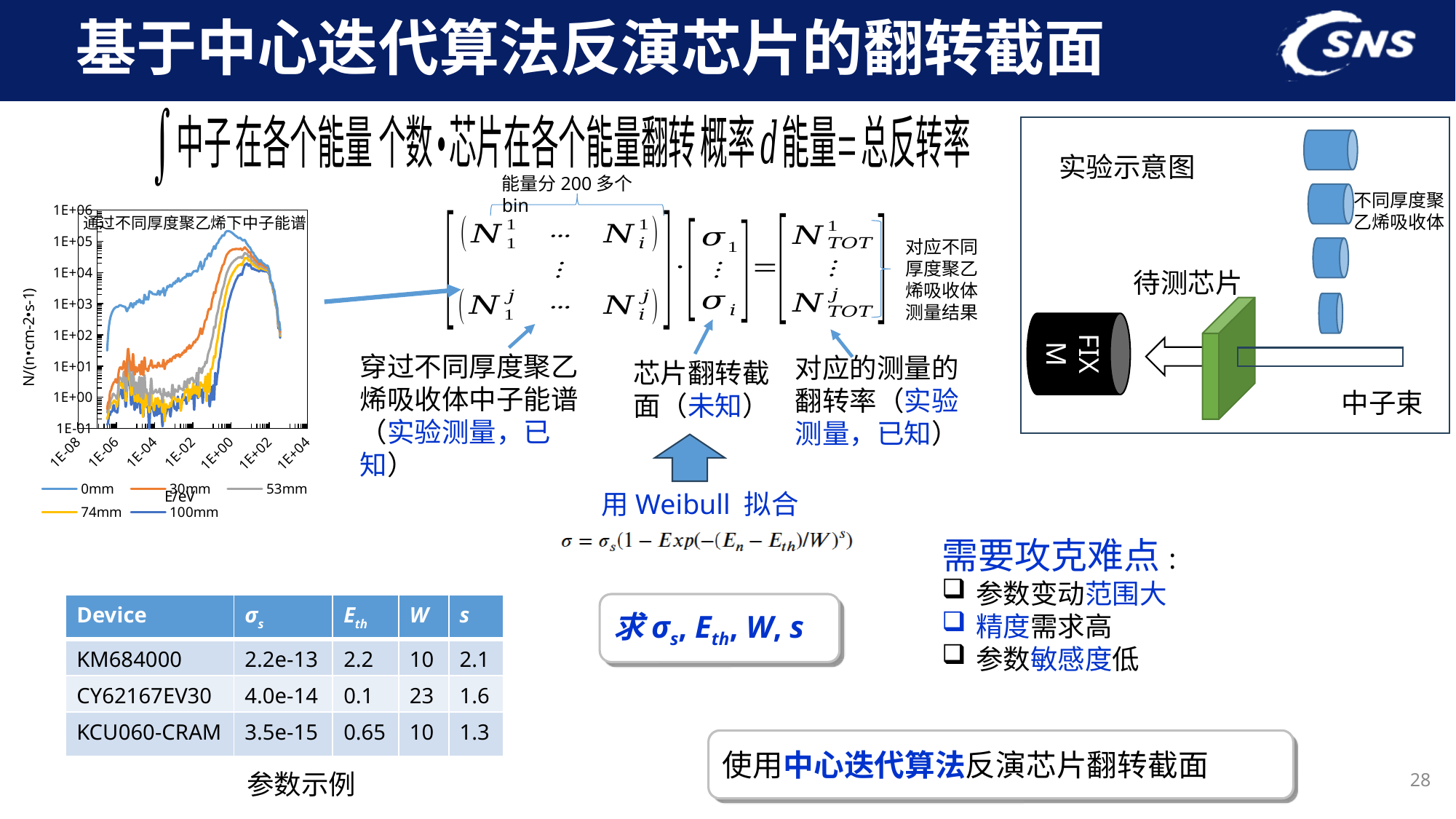
How many tick labels are shown on the x axis of the neutron spectrum chart? 7 In the neutron spectrum chart, at an energy of about 1E-04 eV, which series is higher: 0mm or 100mm? 0mm In the neutron spectrum chart, is the value of the 100mm curve at about 1E-04 eV greater or less than 1E+02? less In the neutron spectrum chart, at about 1E-02 eV, which series is higher: 30mm or 53mm? 30mm In the neutron spectrum chart, which series has the highest values across most of the energy range? 0mm In the neutron spectrum chart, is the value of the 30mm curve at about 1E-04 eV greater or less than 1E+03? less How many series does the legend of the neutron spectrum chart list? 5 What is the title of the chart on the left of the slide? 通过不同厚度聚乙烯下中子能谱 In the neutron spectrum chart, is the peak value of the 0mm curve greater or less than 1E+03? greater What kind of chart is shown on the left of the slide (通过不同厚度聚乙烯下中子能谱)? line chart What are the legend entries of the neutron spectrum chart? 0mm, 30mm, 53mm, 74mm, 100mm